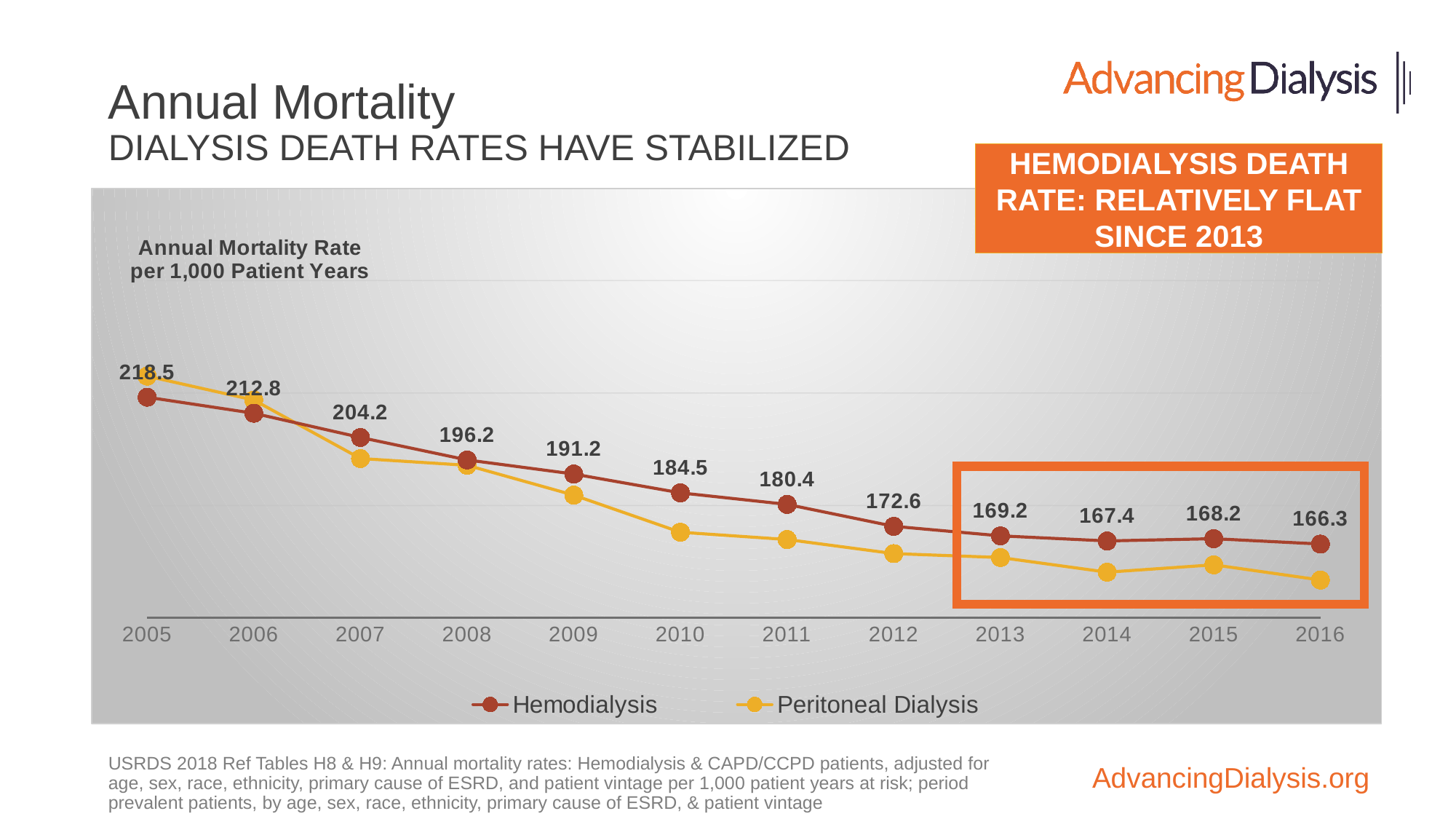
What is the difference between the Hemodialysis mortality rates in 2014 and 2015? 0.8 In 2016, which series has the higher mortality rate, Hemodialysis or Peritoneal Dialysis? Hemodialysis What is the Hemodialysis annual mortality rate in 2013? 169.2 What is the Hemodialysis annual mortality rate in 2005? 218.5 By how much did the Hemodialysis mortality rate fall from 2005 to 2016? 52.2 How many series does the legend list? 2 What is the Hemodialysis annual mortality rate in 2010? 184.5 In which year is the Hemodialysis mortality rate highest? 2005 What kind of chart is shown on the slide? Line chart How many years are shown on the x axis of the chart? 12 What is the Hemodialysis annual mortality rate in 2016? 166.3 In which year is the Hemodialysis mortality rate lowest? 2016